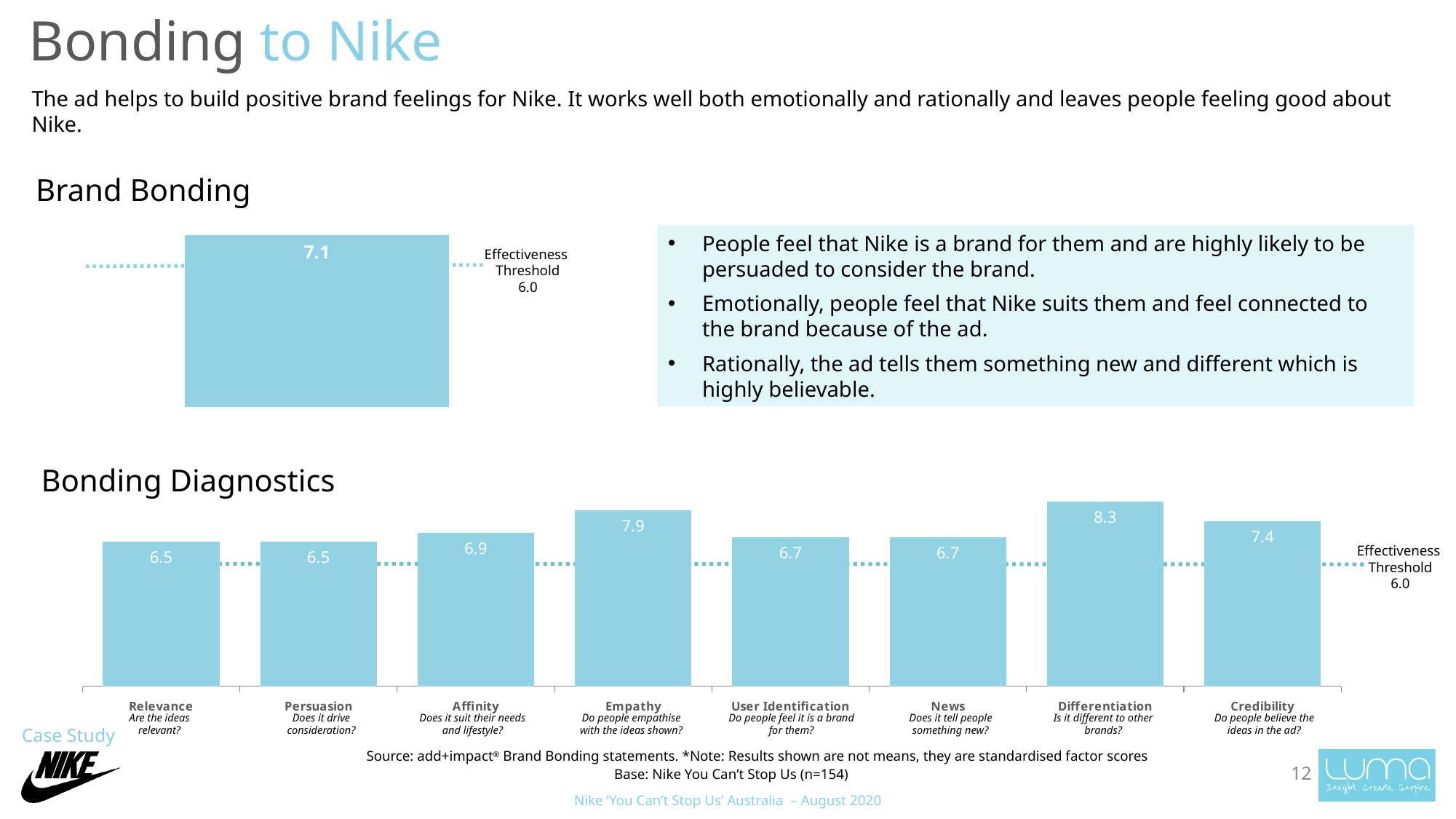
In the Bonding Diagnostics chart, what is the value for User Identification? 6.7 In the Bonding Diagnostics chart, what is the difference between Differentiation and Relevance? 1.8 In the Brand Bonding chart, what is the Effectiveness Threshold value shown? 6.0 In the Bonding Diagnostics chart, what is the value for Credibility? 7.4 In the Brand Bonding chart, what is the value of the bar? 7.1 In the Bonding Diagnostics chart, what is the value for Empathy? 7.9 In the Bonding Diagnostics chart, which is larger, Affinity or News? Affinity In the Bonding Diagnostics chart, is the value for Persuasion greater or less than the Effectiveness Threshold of 6.0? greater In the Bonding Diagnostics chart, how many categories are shown? 8 What kind of chart is the Bonding Diagnostics chart? Bar chart In the Bonding Diagnostics chart, what is the difference between Empathy and Credibility? 0.5 In the Bonding Diagnostics chart, which category has the highest value? Differentiation